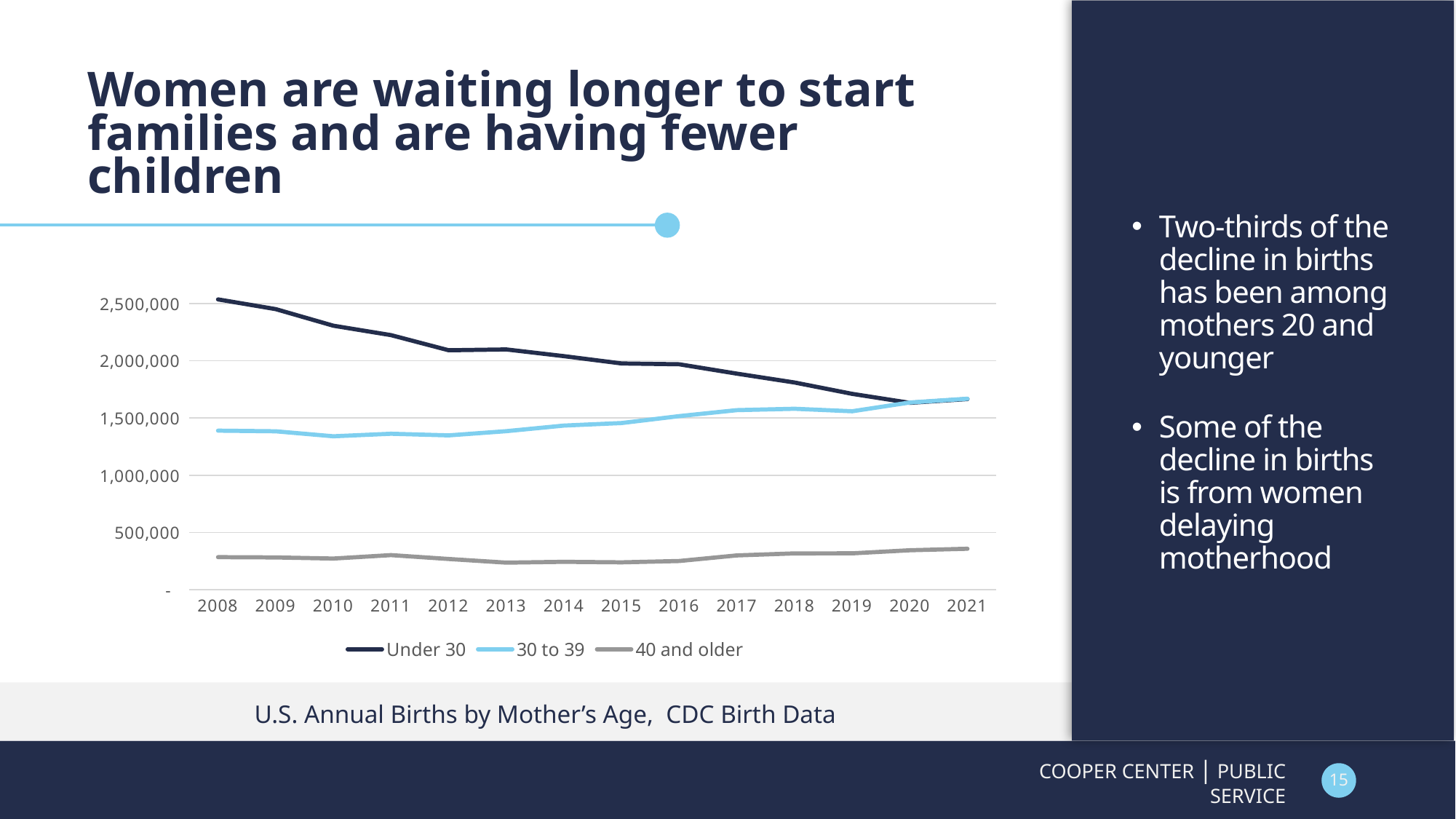
In 2008, which series has the larger value: Under 30 or 30 to 39? Under 30 Is the value for Under 30 in 2008 greater or less than 2,000,000? greater Is the value for 40 and older in 2021 greater or less than 500,000? less How many years are plotted along the x axis of the chart? 14 Is the value for Under 30 in 2021 greater or less than 2,000,000? less Which series has the lowest value in 2015? 40 and older Does the 30 to 39 line rise or fall from 2012 to 2021? Rise Does the Under 30 line rise or fall from 2008 to 2021? Fall What are the first and last years shown on the chart's x axis? 2008 and 2021 How many series does the chart's legend list? 3 What kind of chart is shown on the slide? Line chart